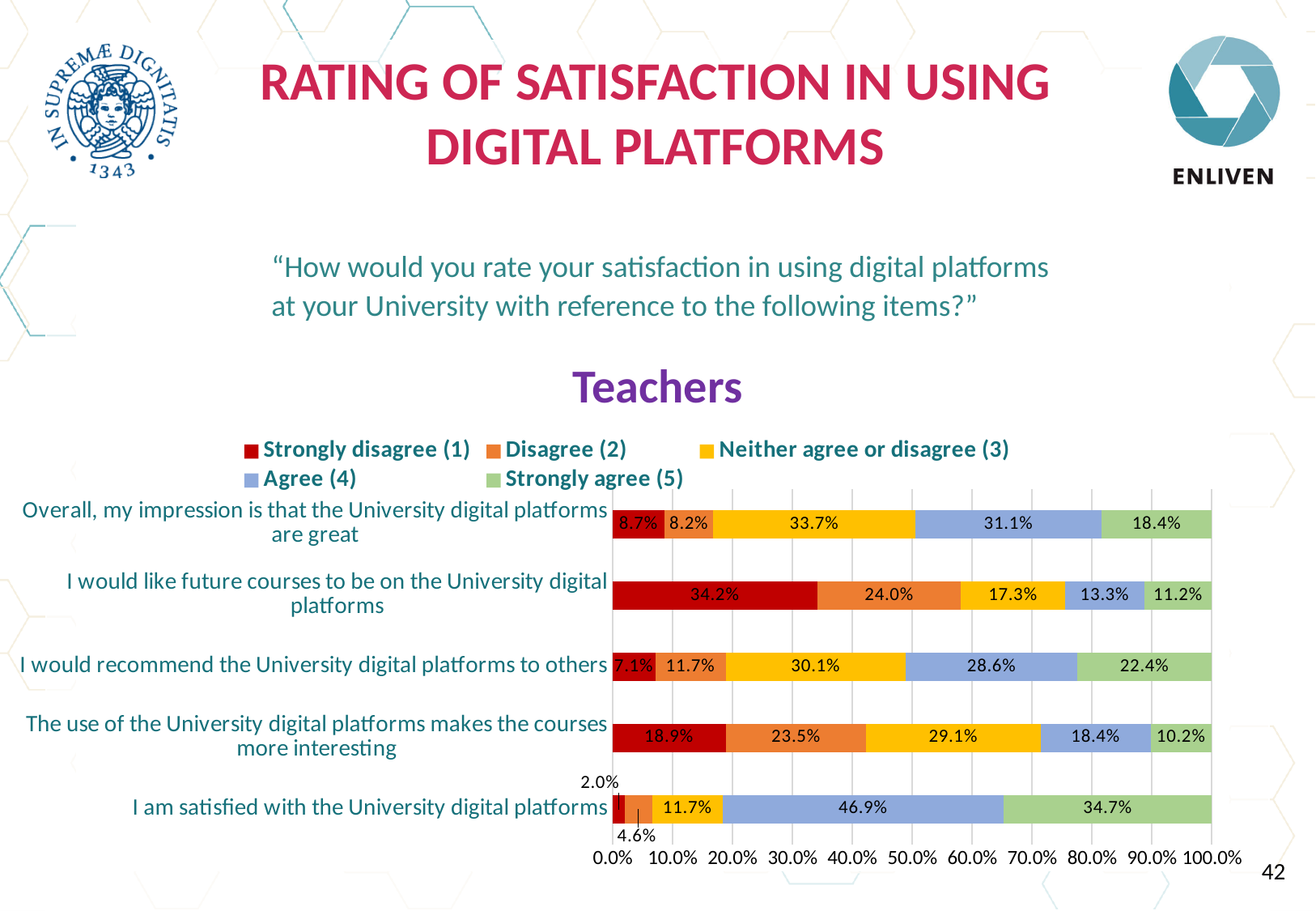
Which is larger: the 'Strongly agree (5)' value for 'I would recommend the University digital platforms to others' or for 'Overall, my impression is that the University digital platforms are great'? I would recommend the University digital platforms to others Which statement has the lowest 'Strongly agree (5)' value? The use of the University digital platforms makes the courses more interesting What is the title of the chart? Teachers How many statements (categories) are plotted in the chart? 5 What kind of chart is shown on the slide? Stacked bar chart What is the 'Strongly agree (5)' value for 'I am satisfied with the University digital platforms'? 34.7% What is the 'Agree (4)' value for 'I would recommend the University digital platforms to others'? 28.6% Which statement has the highest 'Agree (4)' value? I am satisfied with the University digital platforms What is the 'Neither agree or disagree (3)' value for 'Overall, my impression is that the University digital platforms are great'? 33.7% How many series does the legend list? 5 What is the difference between the 'Disagree (2)' values for 'The use of the University digital platforms makes the courses more interesting' and 'I would recommend the University digital platforms to others'? 11.8% What is the 'Strongly disagree (1)' value for 'I would like future courses to be on the University digital platforms'? 34.2%